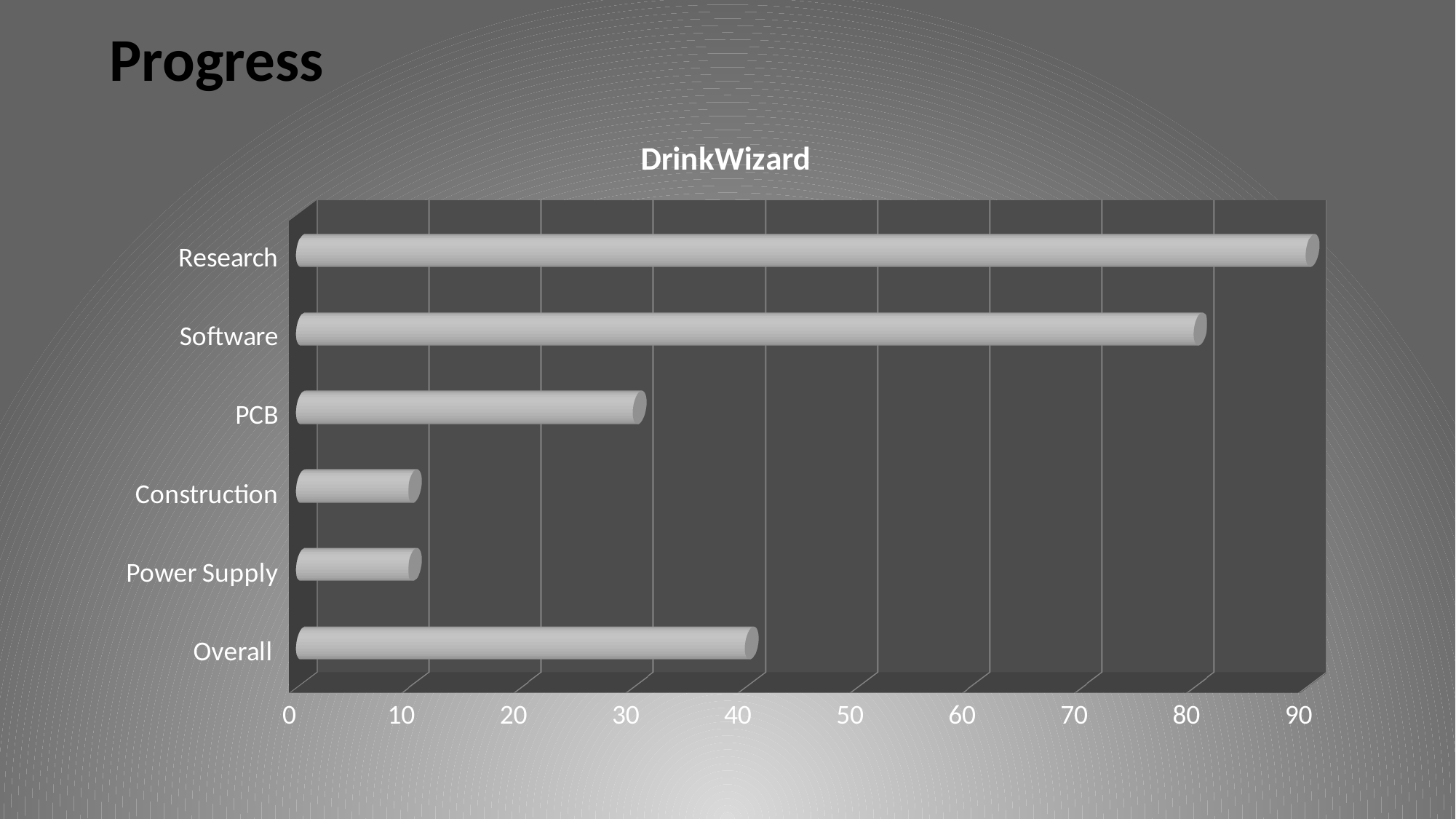
Is the value for Research greater or less than 80? greater Which has the larger value, Research or Software? Research Is the value for Software greater or less than 70? greater Which category has the highest value? Research How many categories are plotted in the chart? 6 Which has the larger value, Software or PCB? Software What kind of chart is shown on the slide? bar chart Which has the larger value, PCB or Overall? Overall Is the value for PCB greater or less than 40? less What is the title of the chart? DrinkWizard